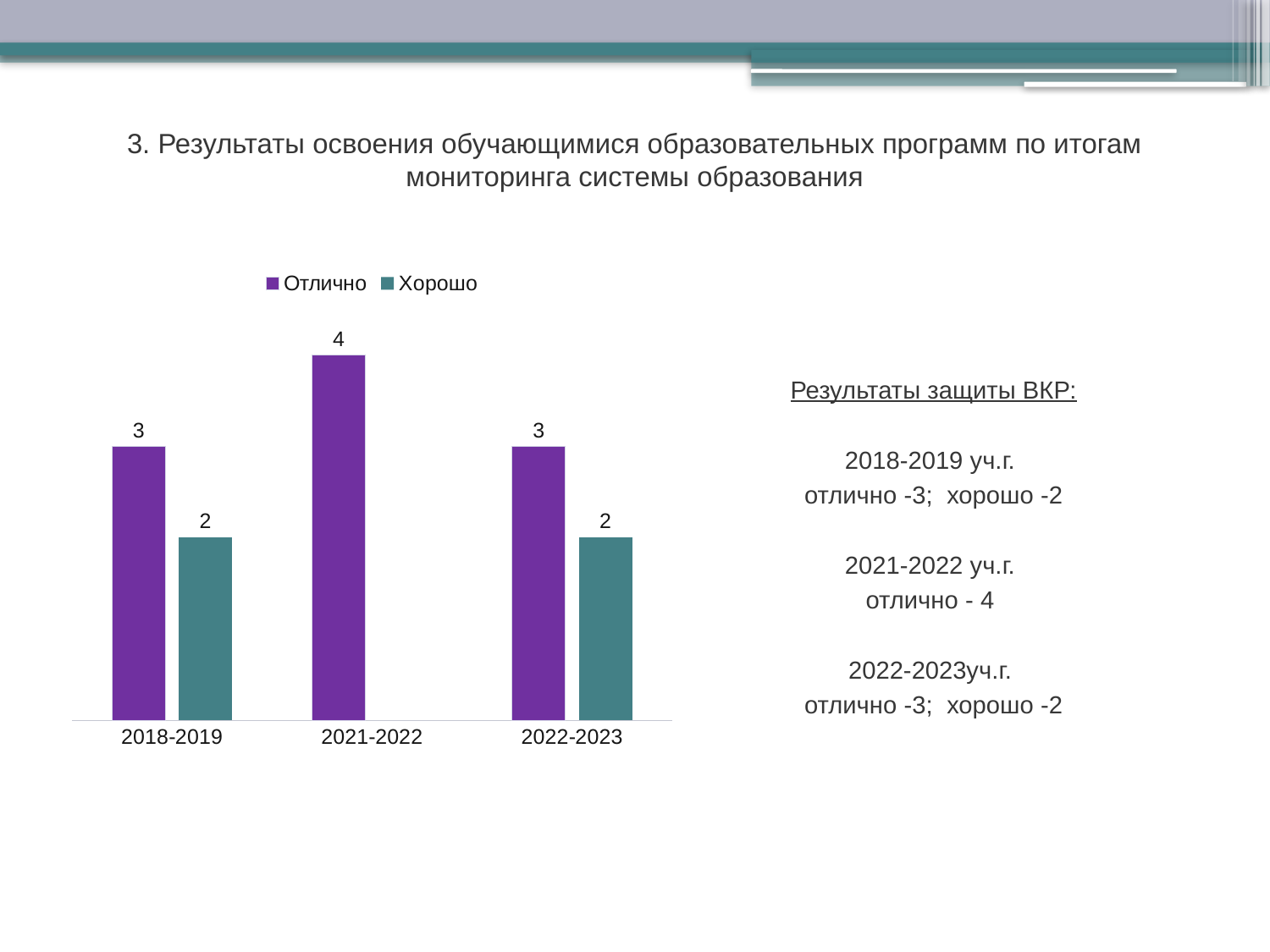
Which series is shown in purple? Отлично Which year has the highest value for Отлично? 2021-2022 What is the difference between Отлично and Хорошо in 2018-2019? 1 How many year categories are shown on the x axis? 3 What is the difference between the Отлично values for 2021-2022 and 2022-2023? 1 What kind of chart is shown on the slide? bar chart How many series does the legend list? 2 What is the value for Отлично in 2018-2019? 3 What is the value for Отлично in 2021-2022? 4 What is the value for Хорошо in 2022-2023? 2 Is there a Хорошо bar for 2021-2022? No Which is larger in 2022-2023, Отлично or Хорошо? Отлично